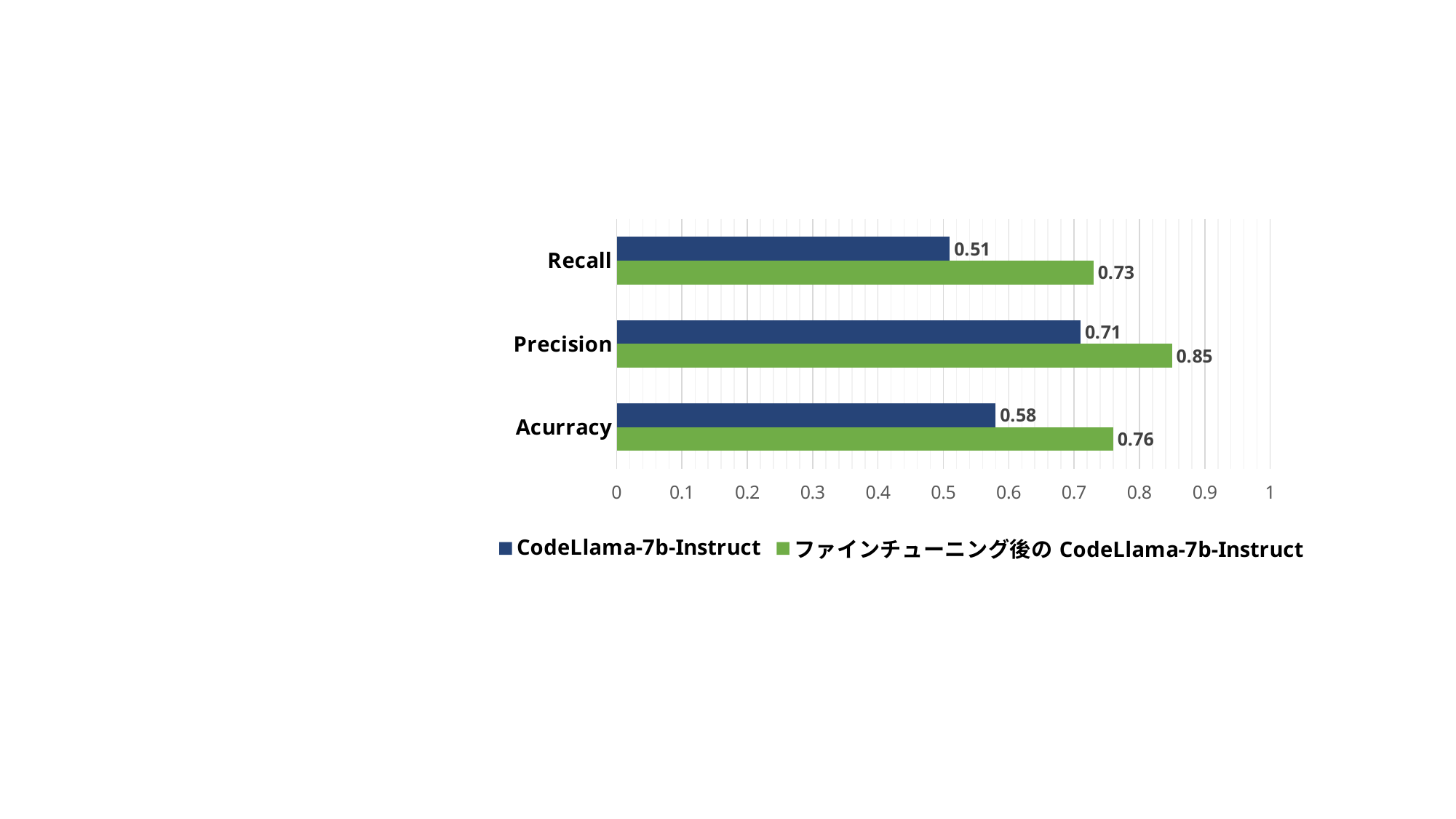
What is the difference between the Acurracy values of ファインチューニング後の CodeLlama-7b-Instruct and CodeLlama-7b-Instruct? 0.18 How many metric categories are shown on the chart? 3 What is the Precision value for ファインチューニング後の CodeLlama-7b-Instruct? 0.85 Which series has the larger Recall value, CodeLlama-7b-Instruct or ファインチューニング後の CodeLlama-7b-Instruct? ファインチューニング後の CodeLlama-7b-Instruct What is the difference between the Precision values of ファインチューニング後の CodeLlama-7b-Instruct and CodeLlama-7b-Instruct? 0.14 What kind of chart is shown on the slide? Bar chart How many series does the legend list? 2 What is the Recall value for ファインチューニング後の CodeLlama-7b-Instruct? 0.73 Which metric has the highest value for ファインチューニング後の CodeLlama-7b-Instruct? Precision What is the Acurracy value for CodeLlama-7b-Instruct? 0.58 What is the Recall value for CodeLlama-7b-Instruct? 0.51 Which metric has the lowest value for CodeLlama-7b-Instruct? Recall